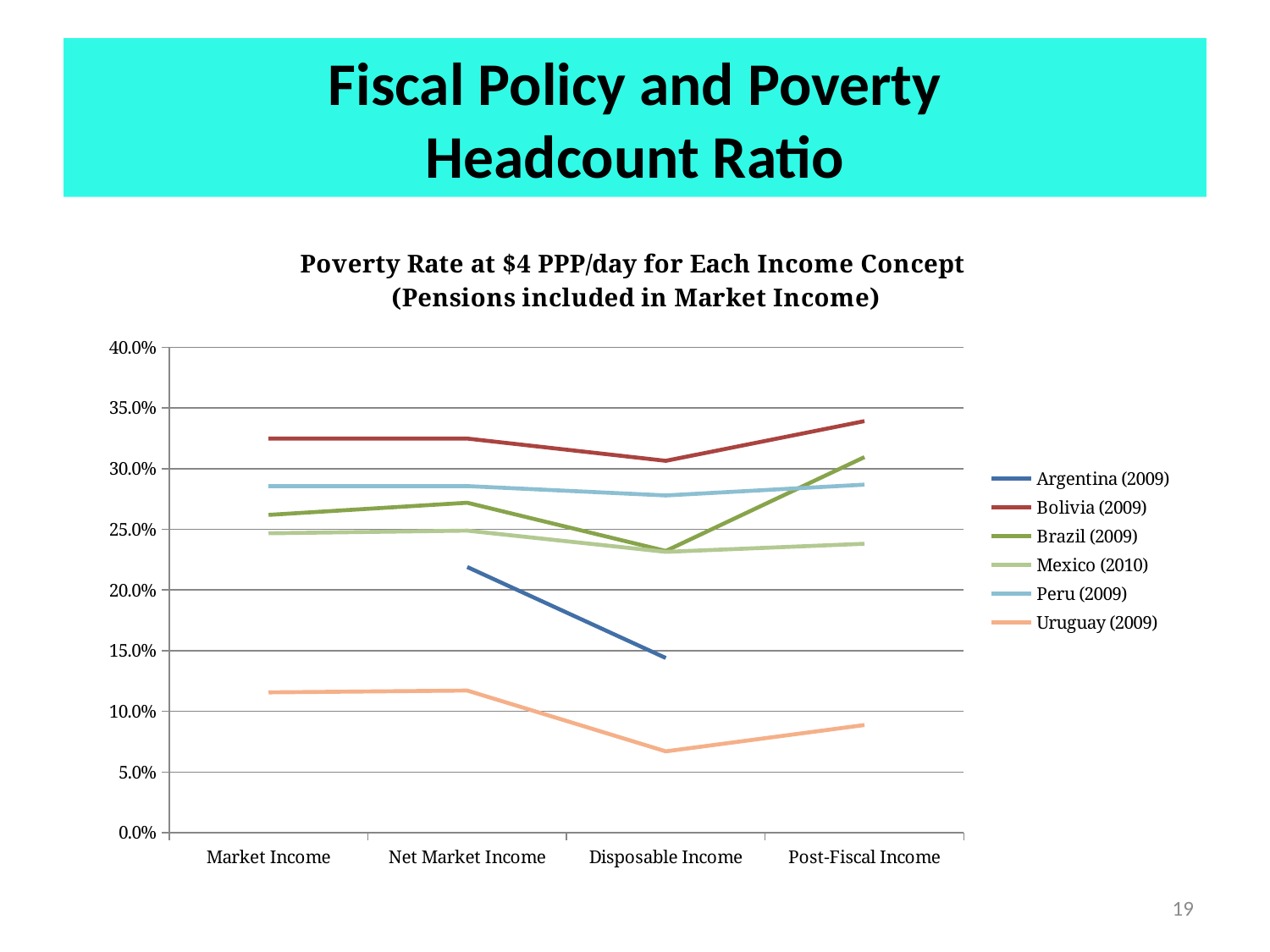
Does the Uruguay (2009) line rise or fall from Disposable Income to Post-Fiscal Income? rise At Post-Fiscal Income, which is larger: the value for Brazil (2009) or Peru (2009)? Brazil (2009) Which country has the highest poverty rate at Market Income? Bolivia (2009) Is the value for Bolivia (2009) at Post-Fiscal Income greater or less than 30.0%? greater Is the value for Argentina (2009) at Disposable Income greater or less than 20.0%? less How many series does the legend list? 6 Is the value for Uruguay (2009) at Disposable Income greater or less than 10.0%? less What kind of chart is shown on the slide? line chart Which series in the legend has data plotted for only two income concepts? Argentina (2009) How many income concepts are shown along the x axis? 4 Does the Argentina (2009) line rise or fall from Net Market Income to Disposable Income? fall Which country has the lowest poverty rate at Market Income? Uruguay (2009)